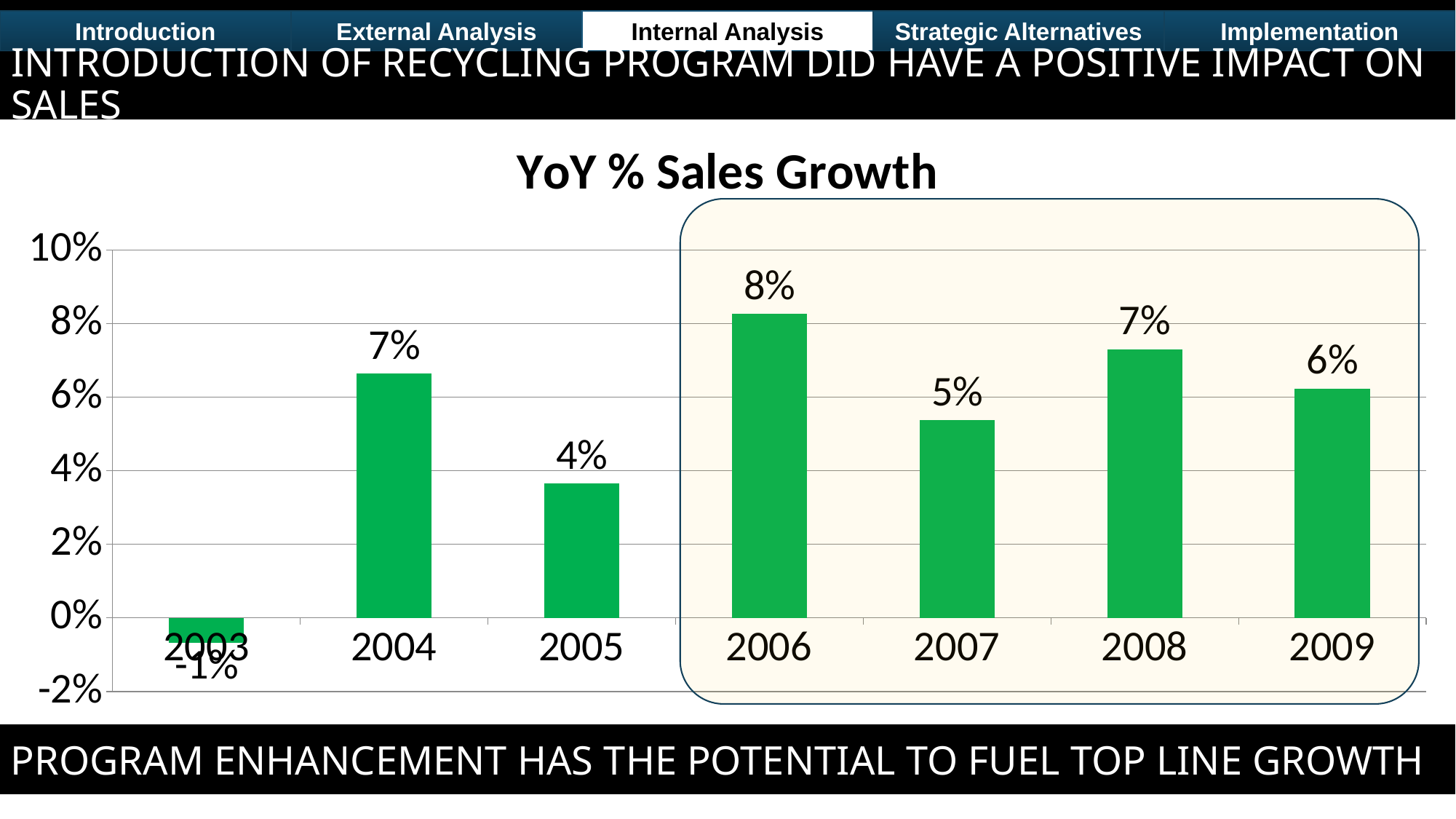
What is the YoY % sales growth shown for 2003? -1% What is the difference between the labelled sales growth for 2006 and 2005? 4% Which year has the larger YoY % sales growth, 2006 or 2007? 2006 What is the YoY % sales growth shown for 2007? 5% What is the title of the chart? YoY % Sales Growth What kind of chart is shown on the slide? Bar chart Which year has the lowest YoY % sales growth? 2003 What is the YoY % sales growth shown for 2006? 8% Is the value for 2007 greater or less than 6%? less What is the YoY % sales growth shown for 2009? 6% How many years are plotted on the chart? 7 Which year has the highest YoY % sales growth? 2006